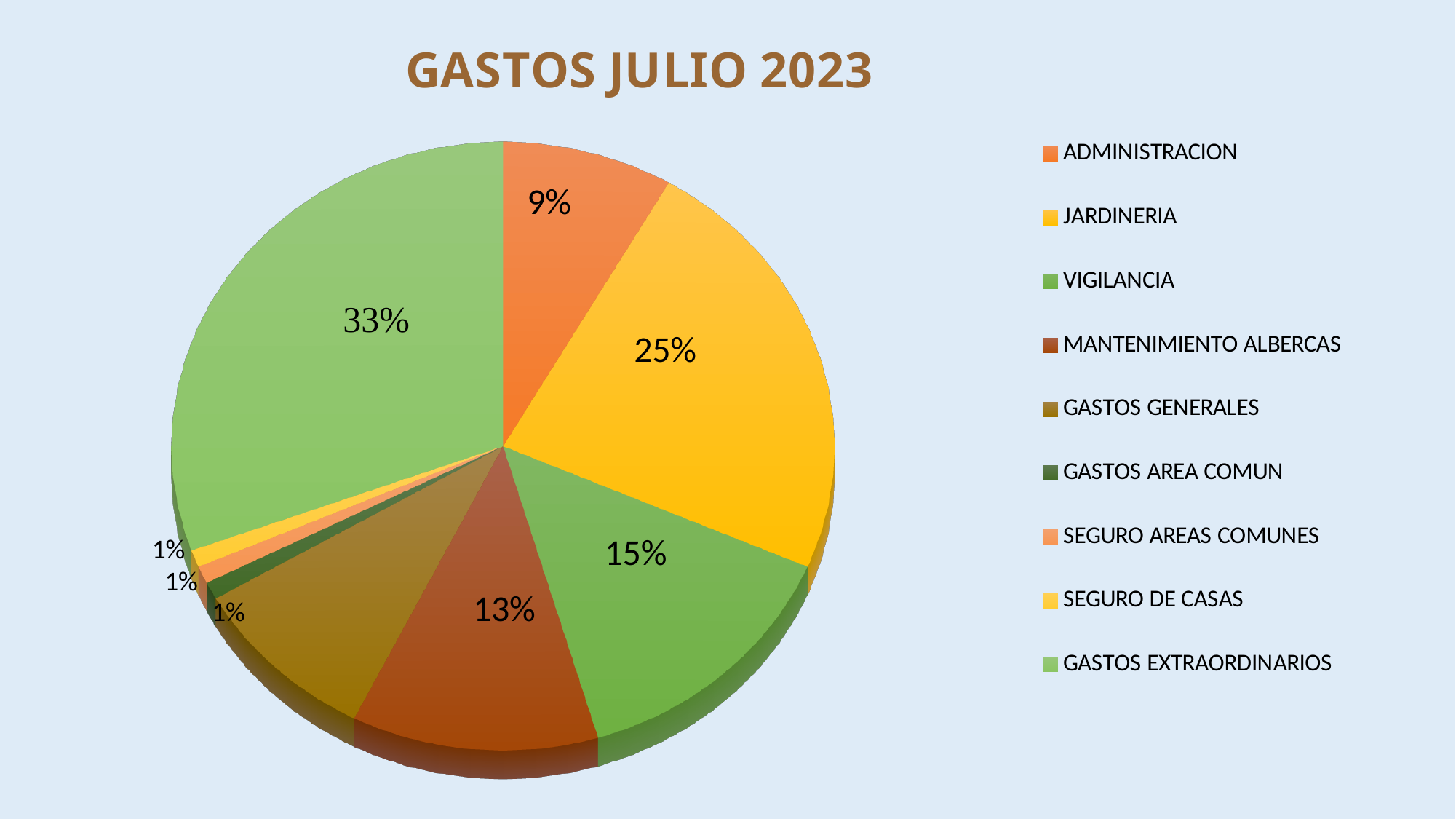
Which is larger, the share for JARDINERIA or the share for VIGILANCIA? JARDINERIA What percentage of the pie does MANTENIMIENTO ALBERCAS represent? 13% What is the difference in percentage points between JARDINERIA and ADMINISTRACION? 16 percentage points How many categories does the legend list? 9 What kind of chart is shown on the slide? Pie chart What percentage of the pie does VIGILANCIA represent? 15% What is the title of the chart? GASTOS JULIO 2023 Which category has the largest share of the pie? GASTOS EXTRAORDINARIOS What percentage of the pie does JARDINERIA represent? 25% What is the difference in percentage points between GASTOS EXTRAORDINARIOS and JARDINERIA? 8 percentage points What percentage of the pie does GASTOS EXTRAORDINARIOS represent? 33% What percentage of the pie does ADMINISTRACION represent? 9%